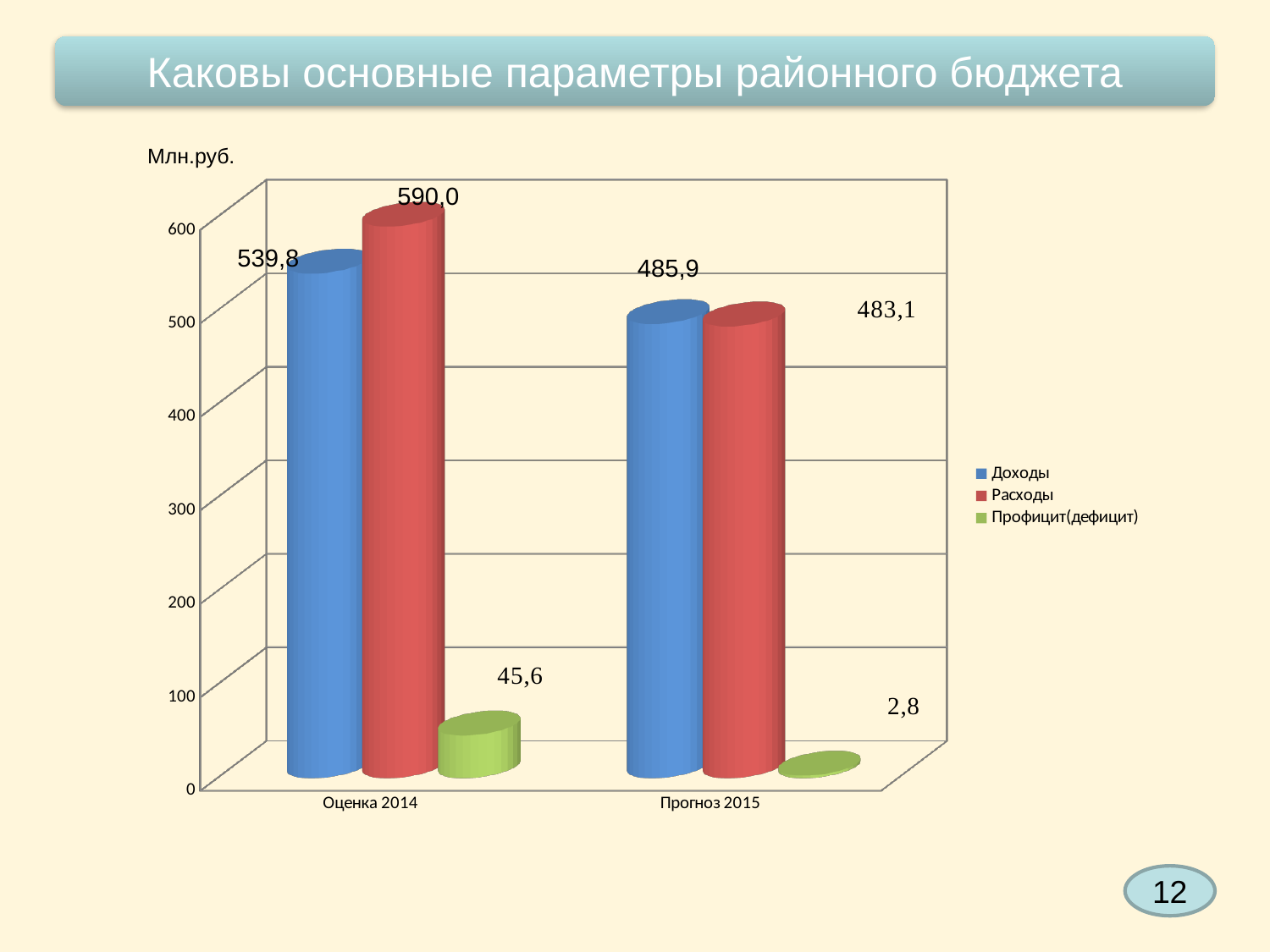
Which series has the lowest value in Прогноз 2015? Профицит(дефицит) By how much does Доходы fall from Оценка 2014 to Прогноз 2015? 53,9 What is the value for Профицит(дефицит) in Прогноз 2015? 2,8 What is the value for Расходы in Оценка 2014? 590,0 What unit is shown above the chart? Млн.руб. Which is larger in Оценка 2014: Доходы or Расходы? Расходы How many series does the legend list? 3 What kind of chart is shown on the slide? Bar chart Which series has the highest value in Оценка 2014? Расходы What is the difference between Расходы and Доходы in Оценка 2014? 50,2 What is the value for Доходы in Оценка 2014? 539,8 What is the value for Расходы in Прогноз 2015? 483,1